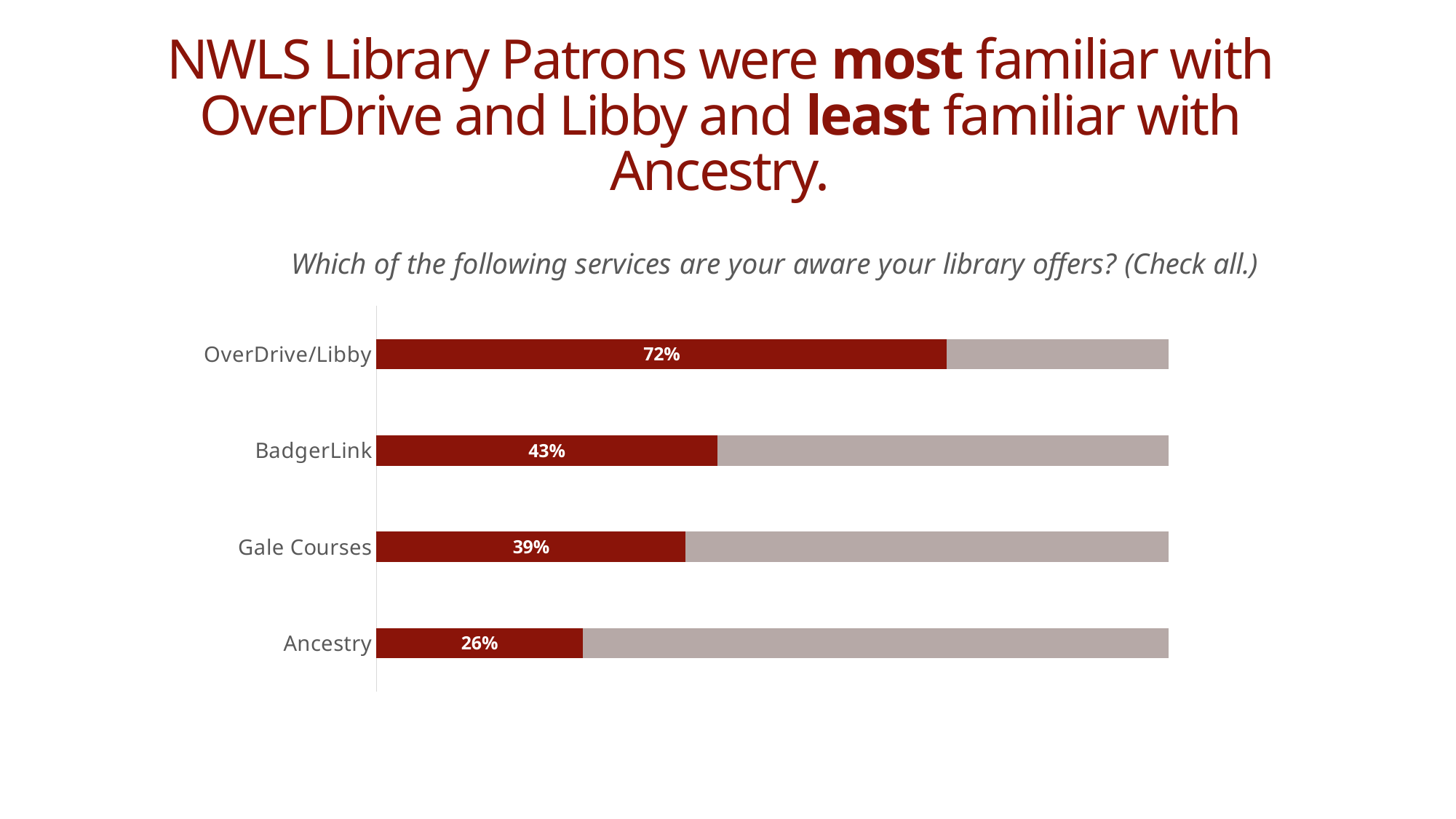
Which service had the highest awareness among patrons? OverDrive/Libby How many services are shown in the chart? 4 What type of chart is shown on the slide? Bar chart Which has higher awareness, BadgerLink or Gale Courses? BadgerLink What survey question is shown above the chart? Which of the following services are your aware your library offers? (Check all.) What is the difference in awareness between OverDrive/Libby and Ancestry? 46% Which service had the lowest awareness among patrons? Ancestry What is the difference in awareness between BadgerLink and Gale Courses? 4% What percentage of patrons were aware their library offers Gale Courses? 39% What percentage of patrons were aware their library offers Ancestry? 26% What percentage of patrons were aware their library offers BadgerLink? 43% What percentage of patrons were aware their library offers OverDrive/Libby? 72%